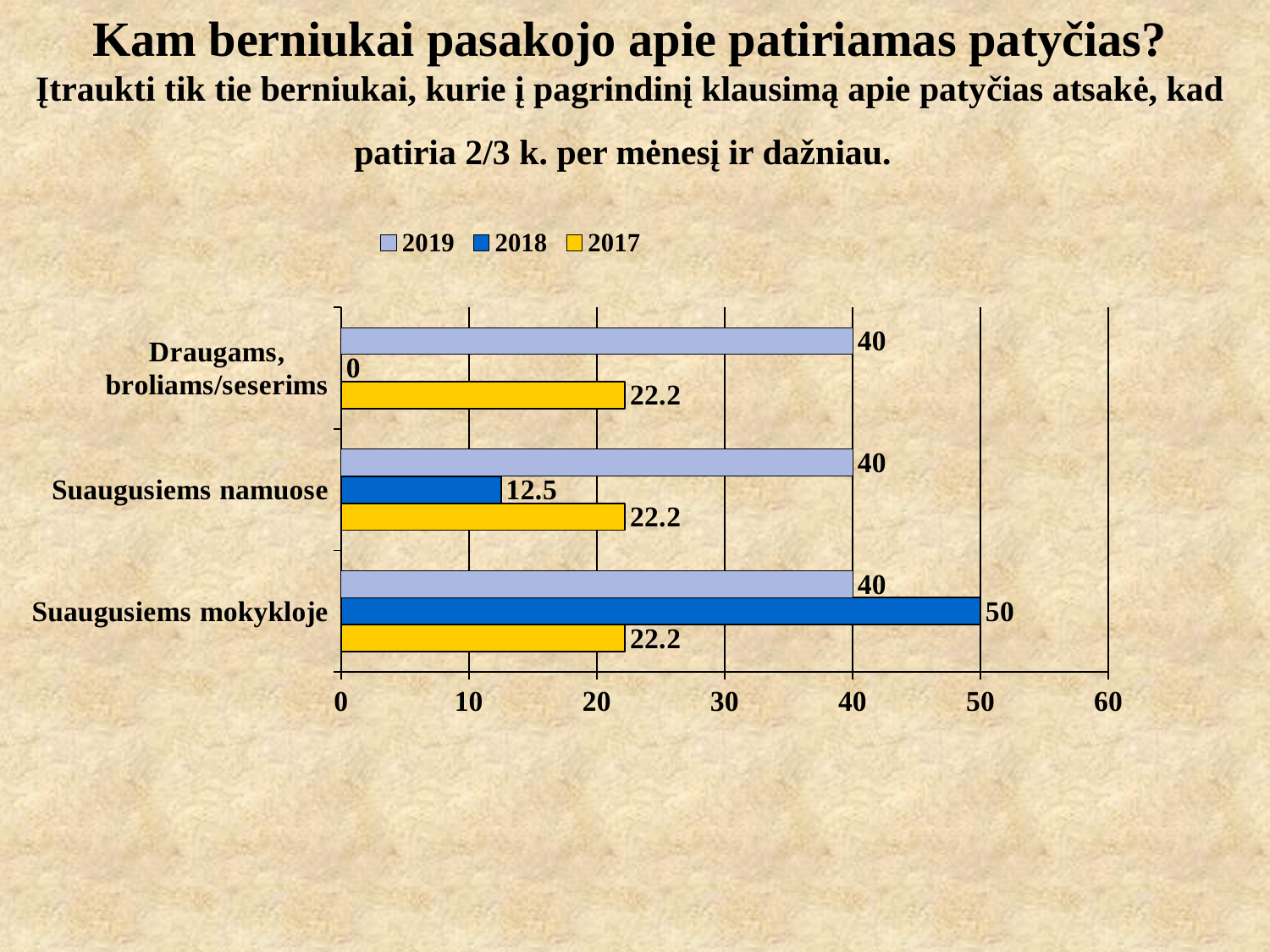
How many categories are shown on the chart? 3 Which category has the highest 2018 value? Suaugusiems mokykloje What is the 2019 value for Suaugusiems namuose? 40 What is the 2018 value for Suaugusiems mokykloje? 50 What kind of chart is shown on the slide? bar chart How many series does the legend list? 3 Which series is shown in yellow? 2017 What is the 2018 value for Draugams, broliams/seserims? 0 Which is larger for Suaugusiems namuose: the 2019 value or the 2018 value? 2019 Which category has the lowest 2018 value? Draugams, broliams/seserims What is the 2017 value for Suaugusiems namuose? 22.2 What is the difference between the 2018 and 2017 values for Suaugusiems mokykloje? 27.8